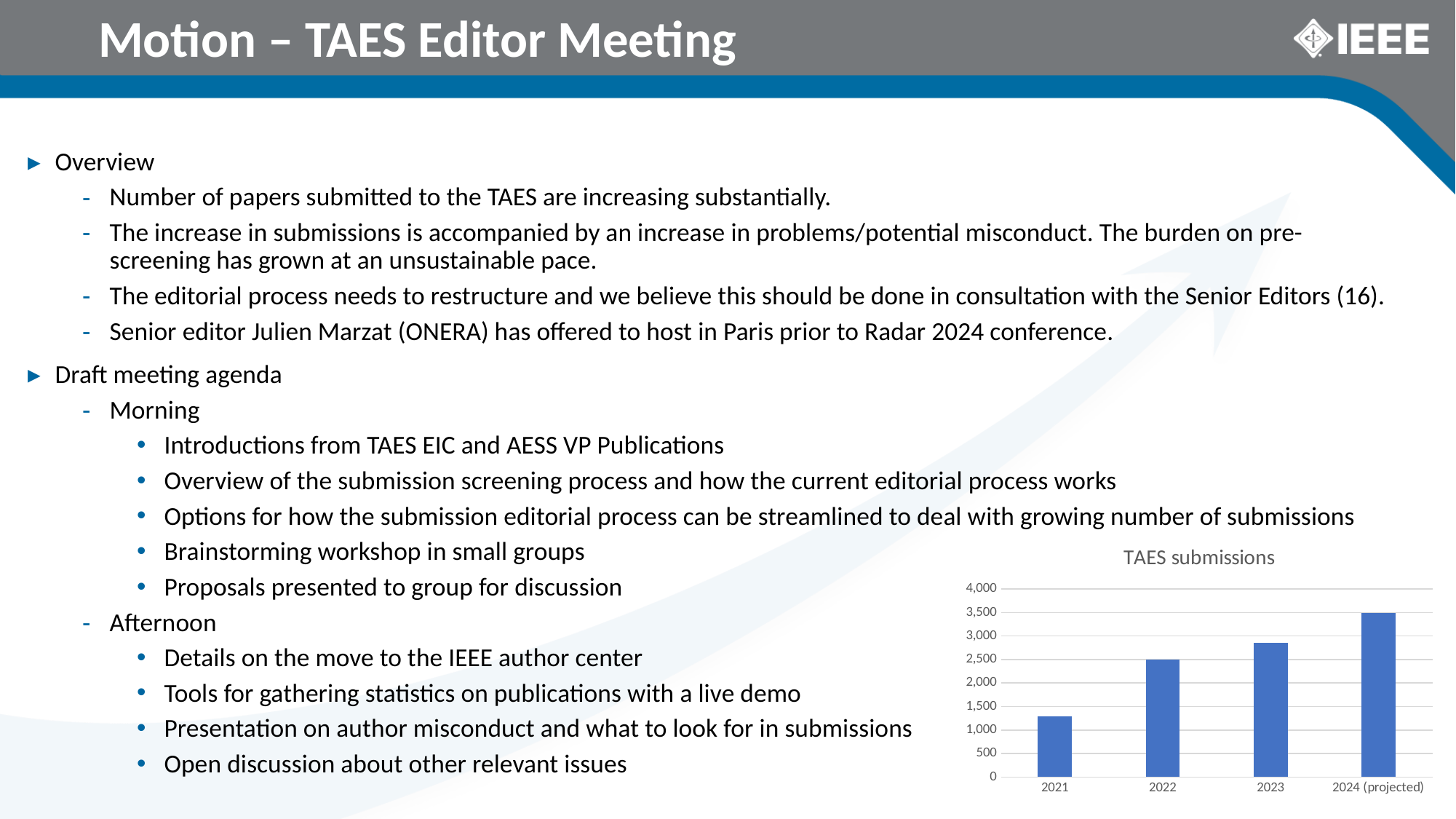
Is the value for 2023 greater or less than 2,500? greater Is the value for 2023 greater or less than 3,000? less Do the TAES submissions rise or fall from 2021 to 2024 (projected)? rise What is the title of the chart? TAES submissions Is the value for 2021 greater or less than 1,000? greater What kind of chart is shown on the slide? bar chart Which year has more TAES submissions, 2022 or 2023? 2023 Which year has the highest number of TAES submissions in the chart? 2024 (projected) What is the label of the last category on the x axis of the chart? 2024 (projected) How many years (categories) are shown on the x axis of the chart? 4 Which year has the lowest number of TAES submissions in the chart? 2021